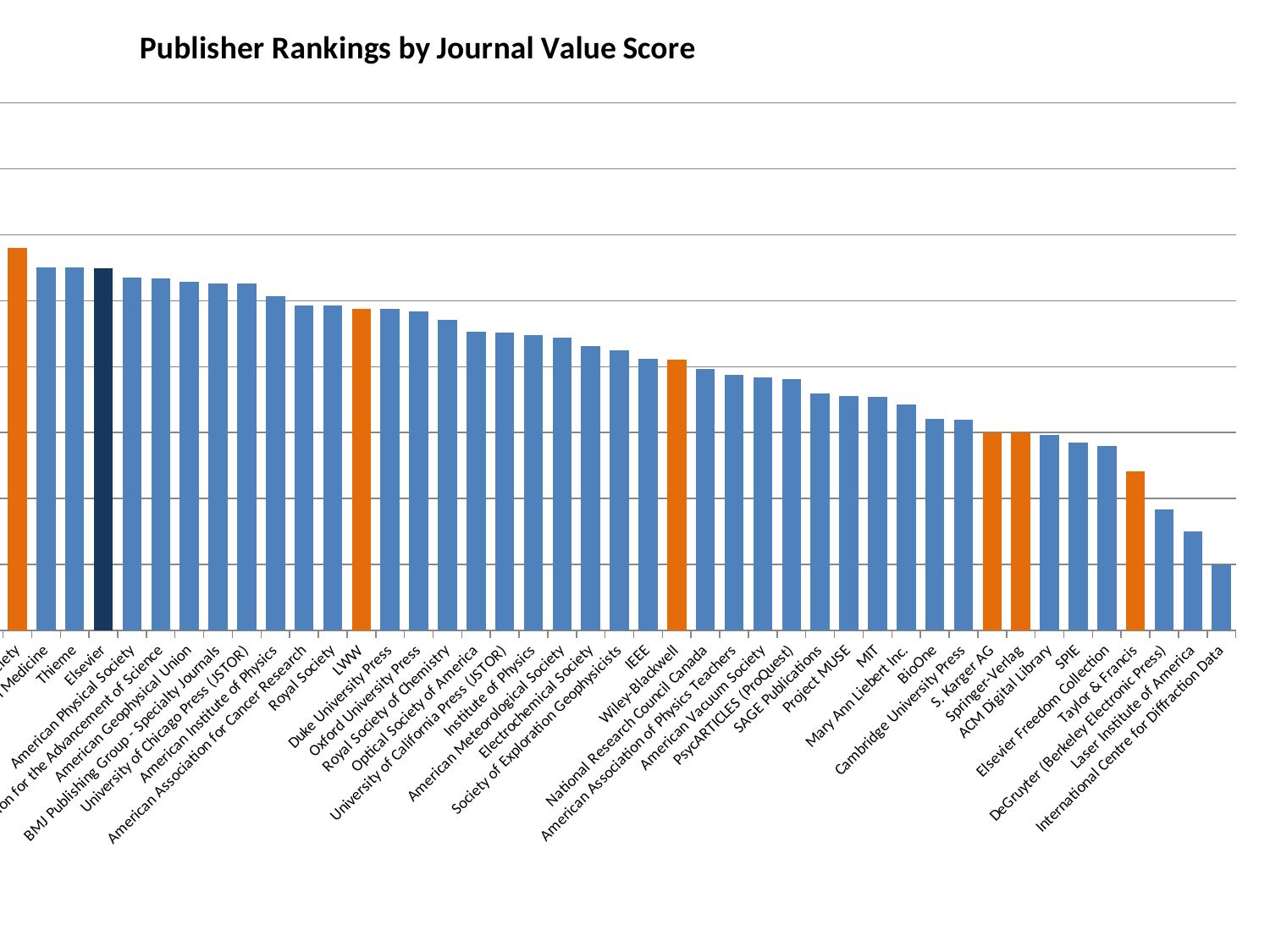
Which publisher's bar is shown in dark navy rather than blue or orange? Elsevier Which has the higher journal value score, LWW or Wiley-Blackwell? LWW Which has the higher journal value score, Thieme or MIT? Thieme Which has the higher journal value score, IEEE or SPIE? IEEE Do the bar values rise or fall moving from left to right along the x axis? Fall What kind of chart is shown on the slide? Bar chart What is the title of the chart? Publisher Rankings by Journal Value Score Which publisher has the lowest journal value score in the chart? International Centre for Diffraction Data